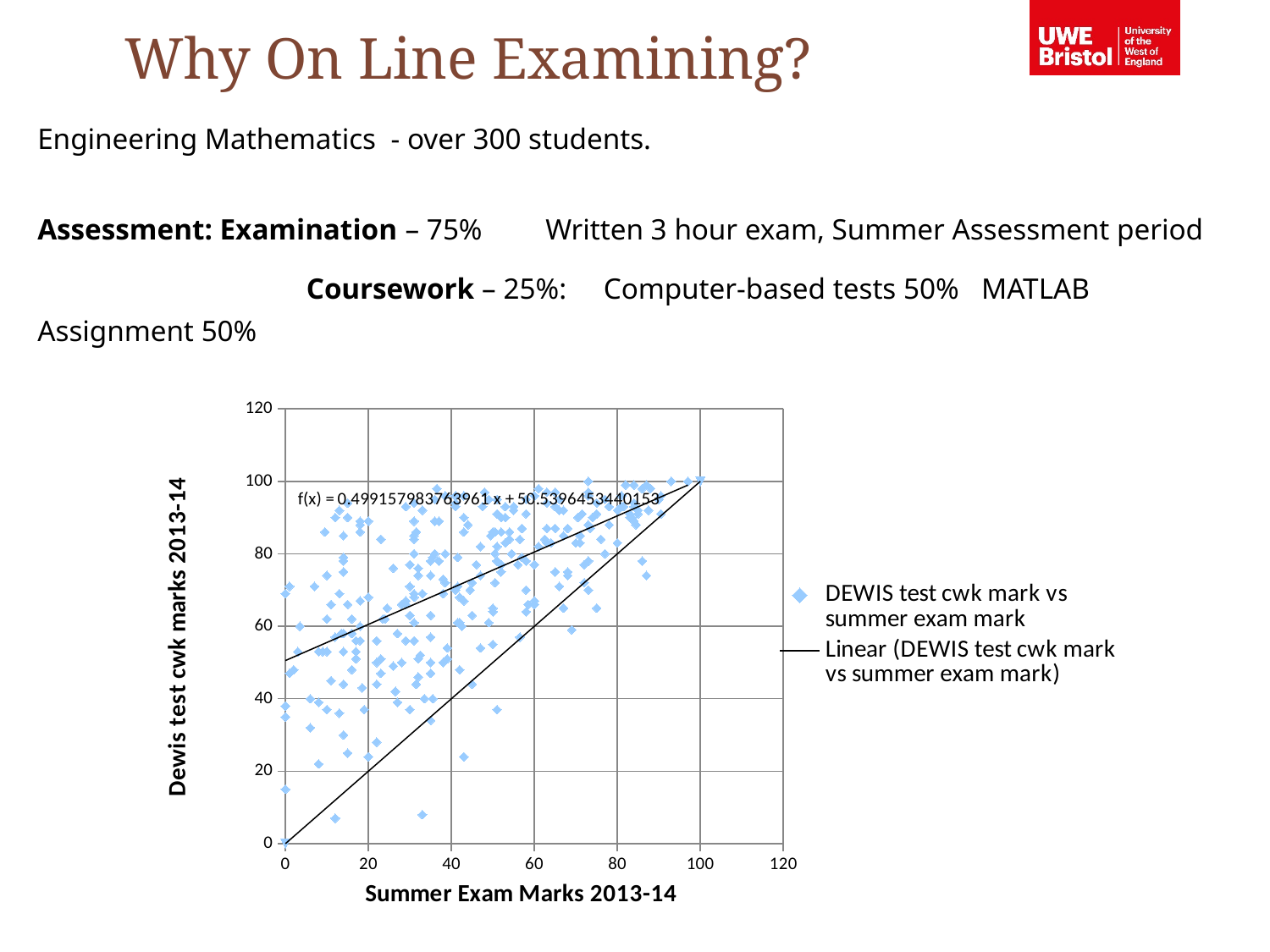
What is the title of the horizontal axis of the chart? Summer Exam Marks 2013-14 What is the slope of the linear trendline equation printed on the chart? 0.499157983763961 What is the title of the vertical axis of the chart? Dewis test cwk marks 2013-14 Does the fitted linear trendline rise or fall as the summer exam mark increases? Rises What kind of chart is shown on the slide? Scatter chart Is the intercept of the linear trendline greater or less than 40? greater What is the maximum value shown on the vertical axis of the chart? 120 What is the maximum value shown on the horizontal axis of the chart? 120 How many entries does the chart legend list? 2 What is the intercept of the linear trendline equation printed on the chart? 50.5396453440153 Is the slope of the linear trendline greater or less than 1? less